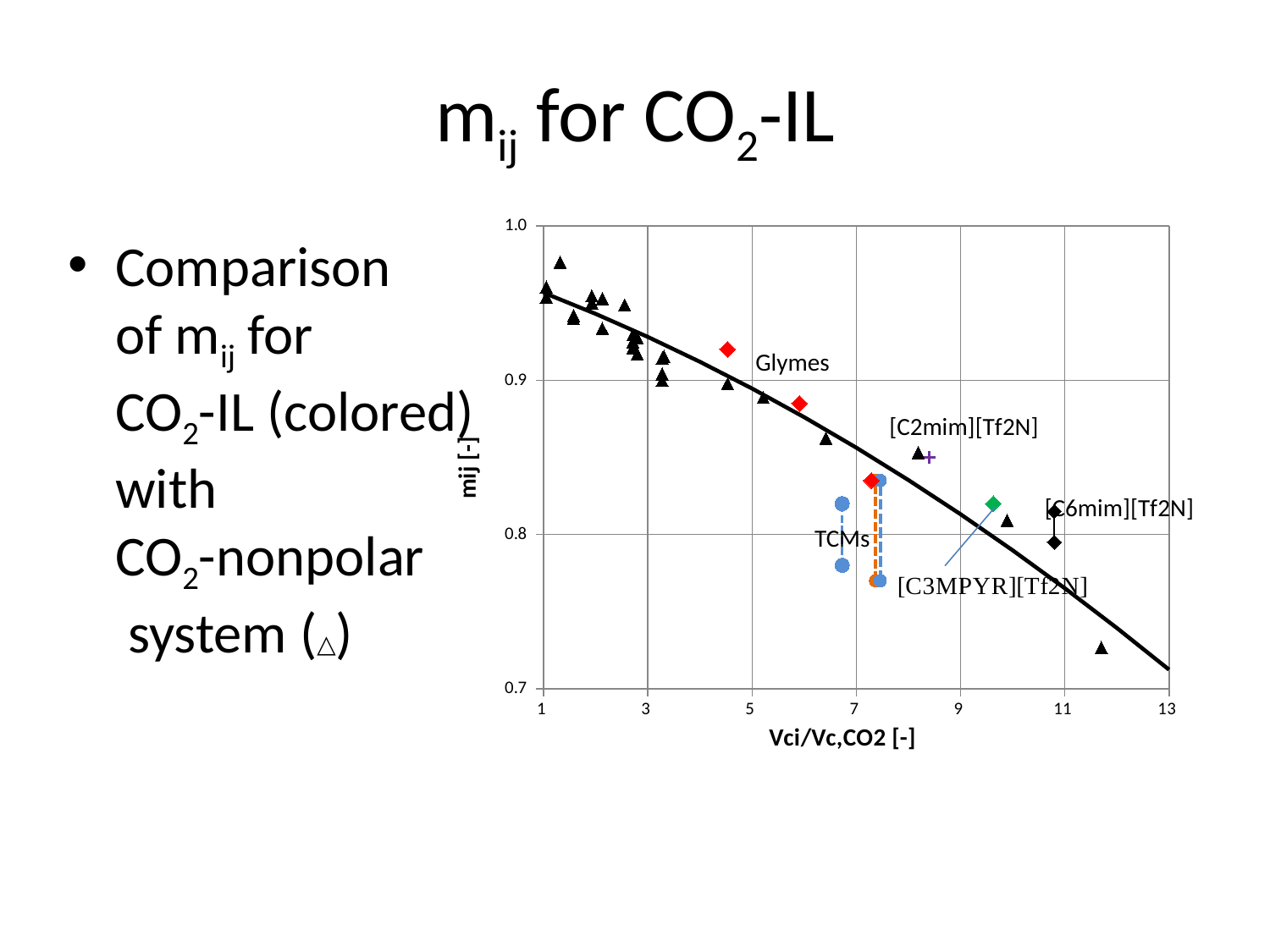
How many ionic liquids with [Tf2N] anions are labeled on the chart? 3 Is the mij value for the [C2mim][Tf2N] point greater or less than 0.8? greater Is the mij value of the highest Glymes point greater or less than 0.9? greater Which has the larger mij value, the [C2mim][Tf2N] point or the [C3MPYR][Tf2N] point? [C2mim][Tf2N] What is the title of the chart? mij for CO2-IL What is the label of the x axis? Vci/Vc,CO2 [-] Is the Vci/Vc,CO2 value for the [C6mim][Tf2N] points greater or less than 9? greater What kind of chart is shown on the slide? scatter chart Which has the larger Vci/Vc,CO2 value, the [C2mim][Tf2N] point or the [C6mim][Tf2N] points? [C6mim][Tf2N] As Vci/Vc,CO2 increases along the x axis, do the mij values generally rise or fall? fall